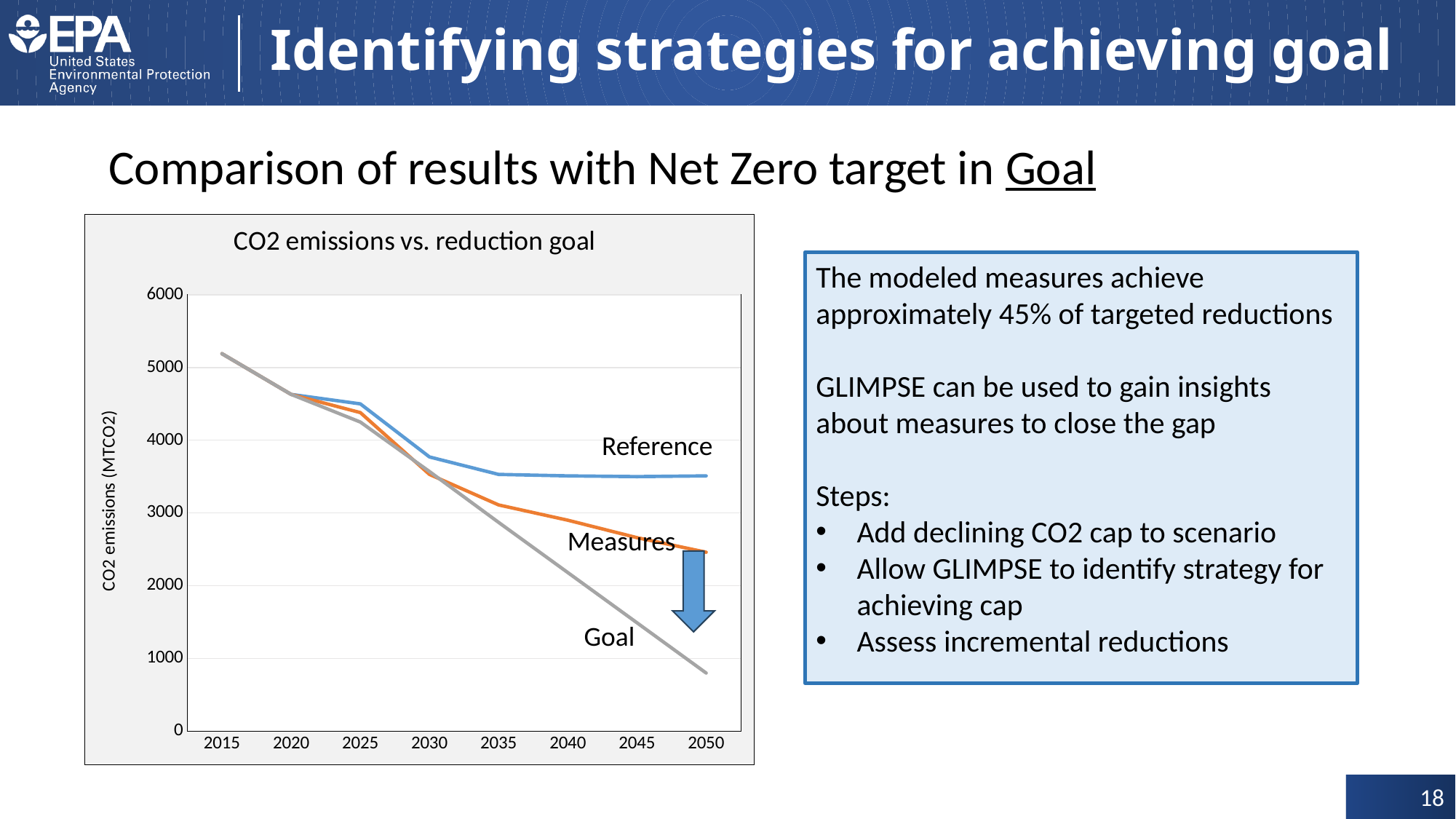
How many series are plotted in the chart? 3 Is the value for Reference in 2050 greater or less than 3000? greater Which series has the lowest value in 2050? Goal Is the value for Measures in 2050 greater or less than 3000? less What is the title of the chart? CO2 emissions vs. reduction goal Is the value for Goal in 2050 greater or less than 1000? less What kind of chart is shown on the slide? line chart In 2050, is the value for Reference or Goal larger? Reference Do the values of the Goal series rise or fall from 2015 to 2050? fall What is the label of the y axis? CO2 emissions (MTCO2) Which series has the highest value in 2050? Reference How many years are marked along the x axis of the chart? 8